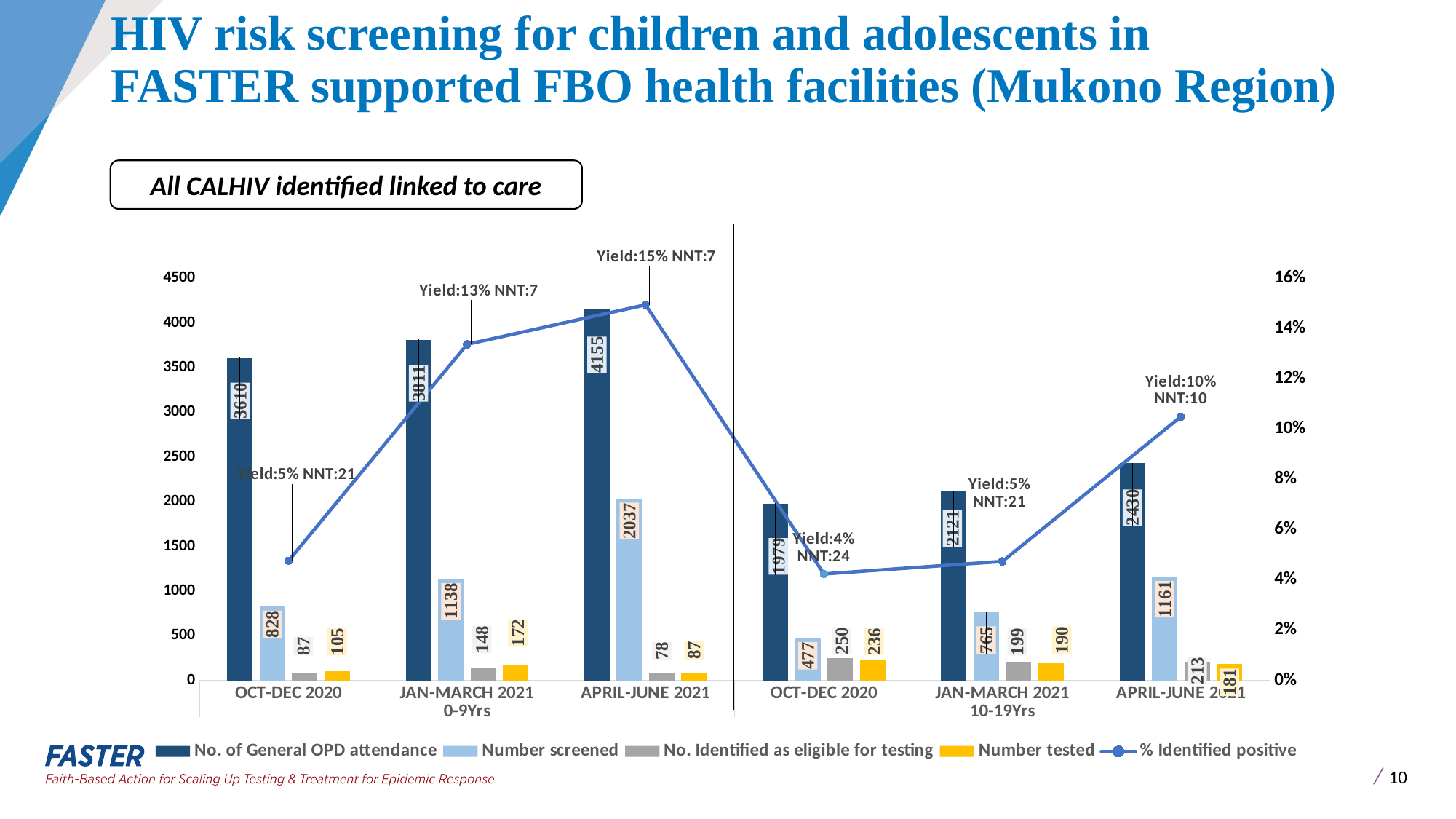
What is the difference between the Number screened and the Number tested for APRIL-JUNE 2021 in the 0-9Yrs group? 1950 Which period and age group has the highest No. of General OPD attendance? APRIL-JUNE 2021, 0-9Yrs Does the No. of General OPD attendance rise or fall across the three periods in the 10-19Yrs group? rise Is the % Identified positive for OCT-DEC 2020 in the 10-19Yrs group greater or less than 6%? less How many series does the legend list? 5 What is the Number screened for JAN-MARCH 2021 in the 10-19Yrs group? 765 What kind of chart is shown on the slide? Combined bar and line chart What is the Number tested for OCT-DEC 2020 in the 10-19Yrs group? 236 What is the No. of General OPD attendance for APRIL-JUNE 2021 in the 0-9Yrs group? 4155 Which period and age group has the lowest Number screened? OCT-DEC 2020, 10-19Yrs Which is larger: the No. Identified as eligible for testing for OCT-DEC 2020 in the 10-19Yrs group or for JAN-MARCH 2021 in the 0-9Yrs group? OCT-DEC 2020, 10-19Yrs What yield is annotated for APRIL-JUNE 2021 in the 0-9Yrs group? 15%